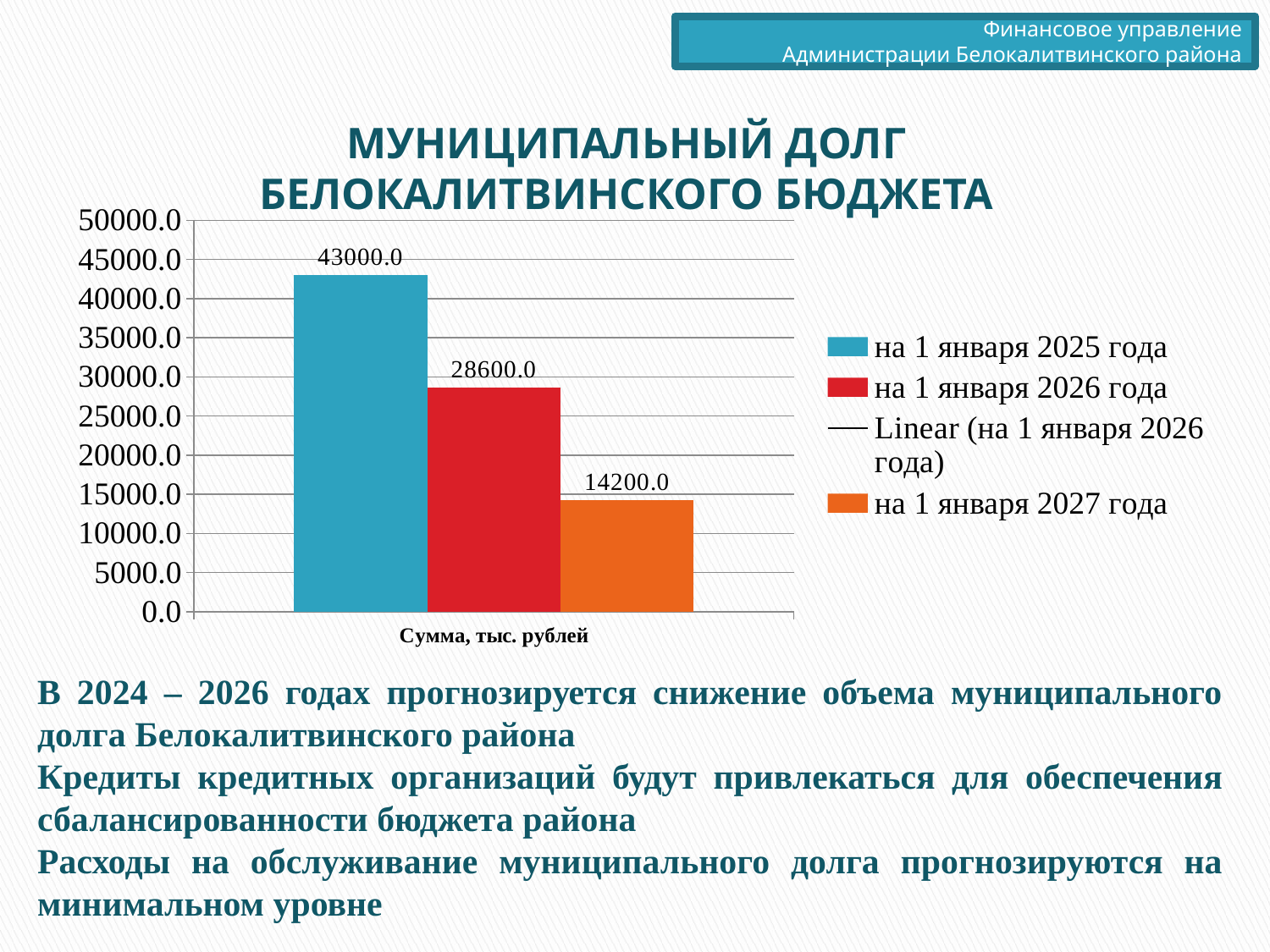
What is the municipal debt value shown for 1 January 2025 (на 1 января 2025 года)? 43000.0 Which is larger: the value for 1 January 2026 or the value for 1 January 2027? на 1 января 2026 года What kind of chart is shown on the slide? bar chart How many bars are plotted on the chart? 3 How many entries does the legend list? 4 What is the municipal debt value shown for 1 January 2026 (на 1 января 2026 года)? 28600.0 What is the label shown under the bars on the horizontal axis? Сумма, тыс. рублей What is the difference between the values for 1 January 2025 and 1 January 2026? 14400.0 Which series has the highest value on the chart? на 1 января 2025 года What is the municipal debt value shown for 1 January 2027 (на 1 января 2027 года)? 14200.0 Which series has the lowest value on the chart? на 1 января 2027 года What is the difference between the values for 1 January 2026 and 1 January 2027? 14400.0